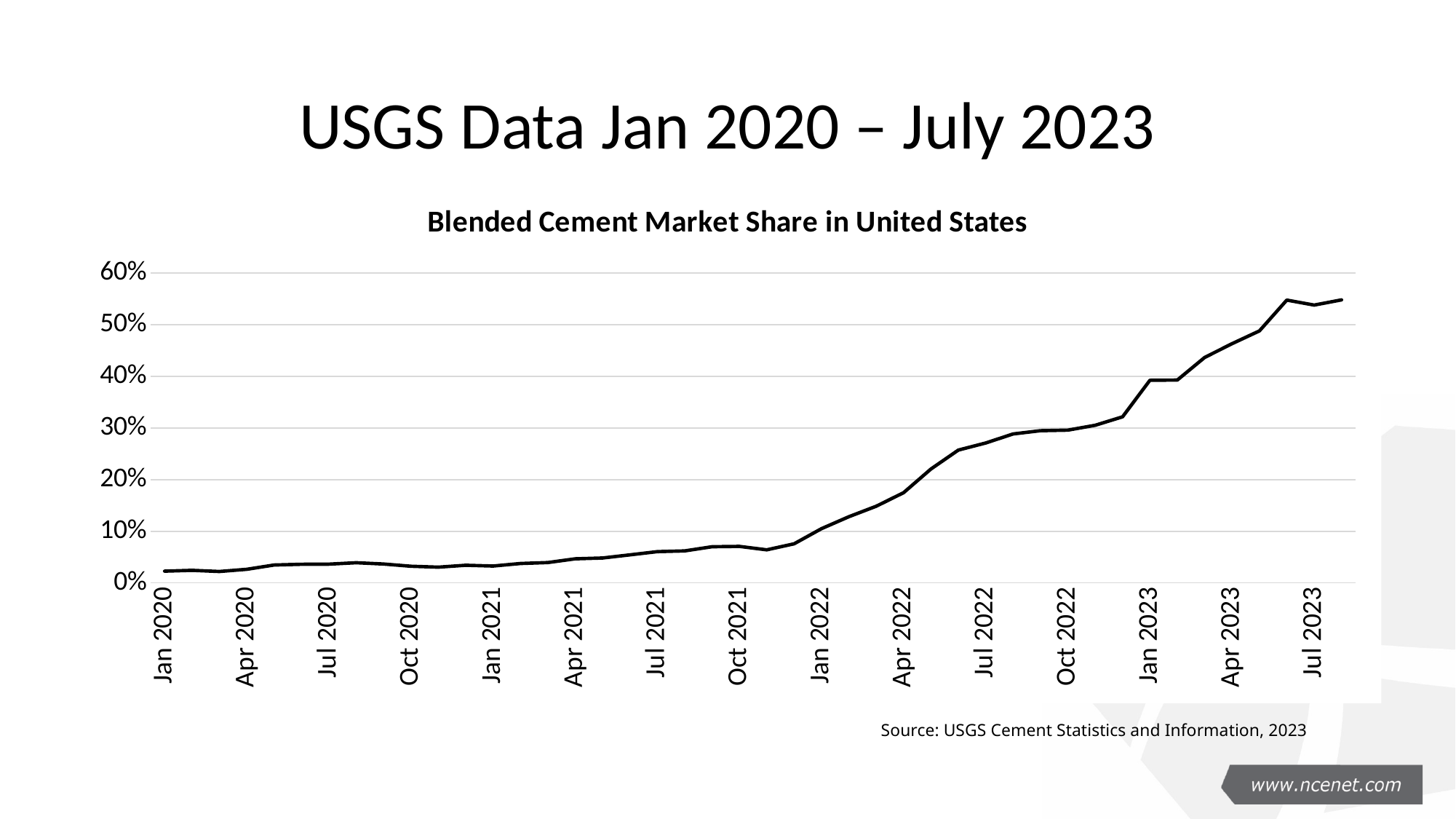
Is the value for Oct 2021 greater or less than 10%? less Is the value for Jul 2021 greater or less than 10%? less Is the value for Jan 2020 greater or less than 10%? less How many date labels are shown on the x axis? 15 What is the source cited below the chart? USGS Cement Statistics and Information, 2023 What kind of chart is shown on the slide? line chart What is the title of the chart? Blended Cement Market Share in United States Which is larger, the value for Jul 2023 or the value for Jan 2020? Jul 2023 Does the blended cement market share generally rise or fall from Jan 2020 to Jul 2023? rise